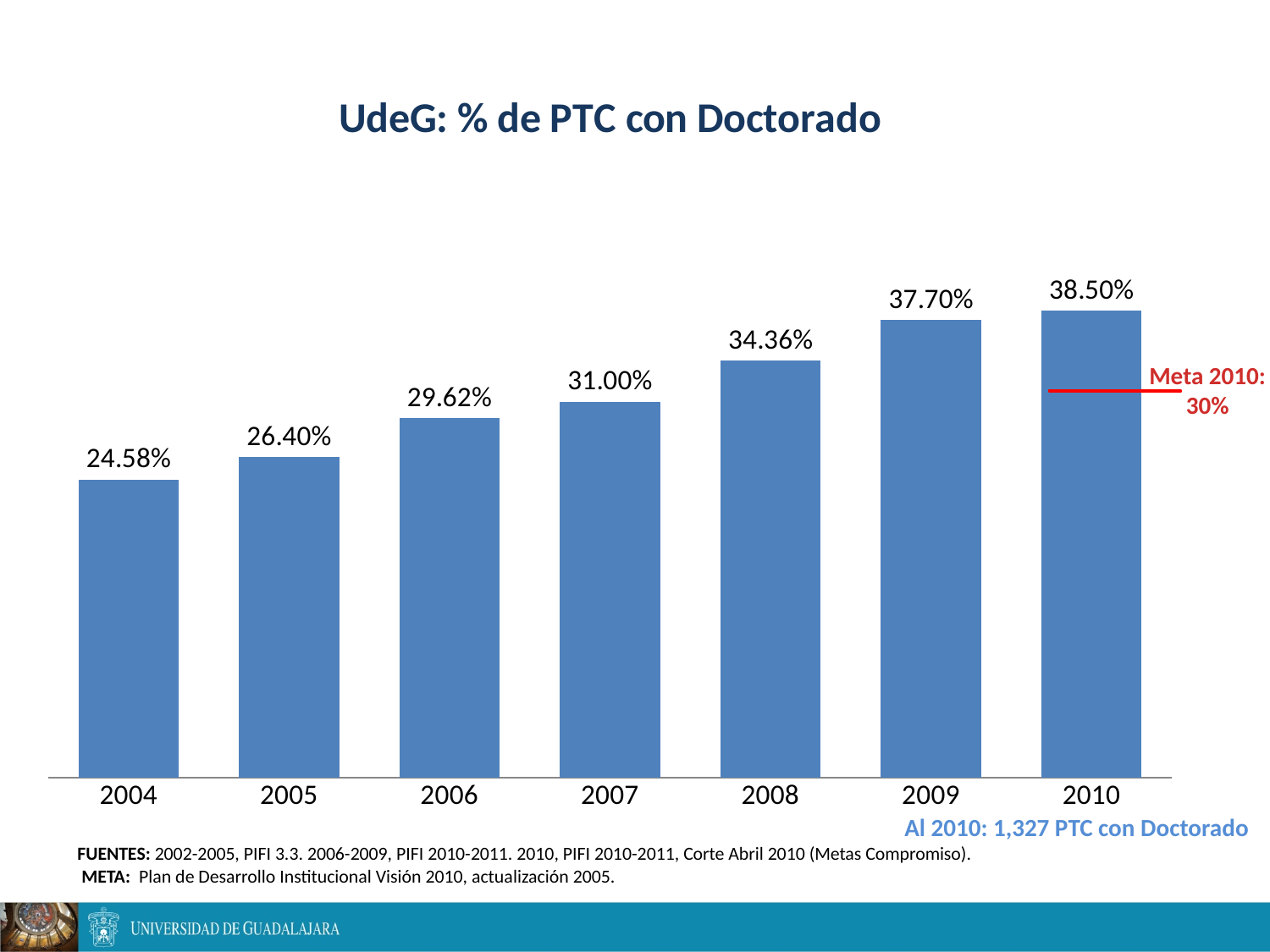
What is the difference between the values for 2008 and 2007? 3.36% What is the value for 2008? 34.36% Which year has the highest value? 2010 Which is larger, the value for 2006 or the value for 2005? 2006 What is the value for 2004? 24.58% Which year has the lowest value? 2004 Do the values rise or fall from 2004 to 2010? Rise What is the title of the chart? UdeG: % de PTC con Doctorado What is the value for 2010? 38.50% What kind of chart is this? Bar chart How many years are shown on the x axis? 7 What is the difference between the values for 2010 and 2009? 0.80%